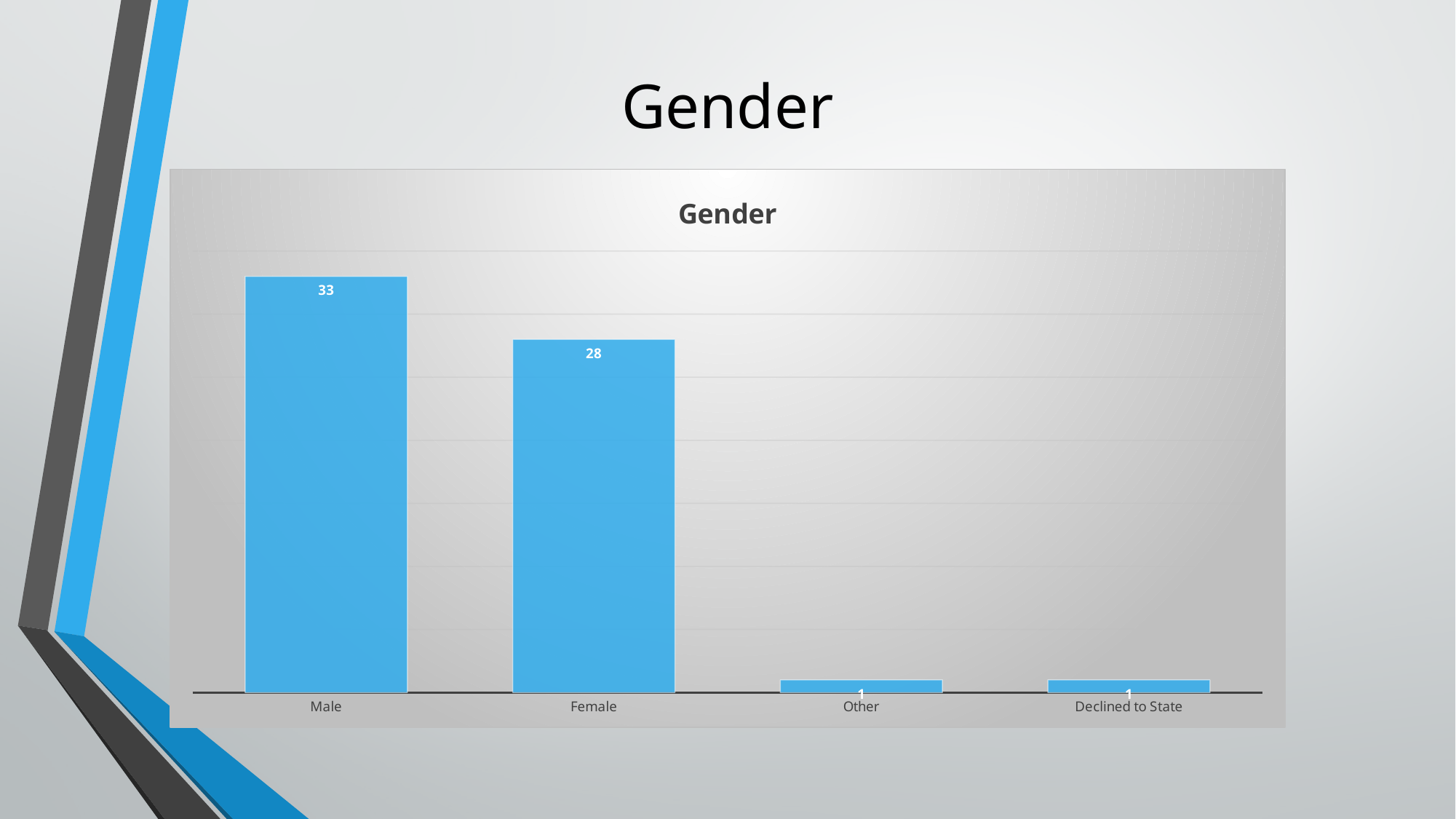
How many categories are shown on the x axis? 4 Which category has the highest value? Male What is the title of the chart? Gender What is the value for Other? 1 What kind of chart is shown? Bar chart What colour are the bars in the chart? Blue What is the value for Declined to State? 1 What is the value for Male? 33 What is the value for Female? 28 Which is larger, the value for Female or the value for Other? Female What is the difference between the values for Female and Declined to State? 27 What is the difference between the values for Male and Female? 5